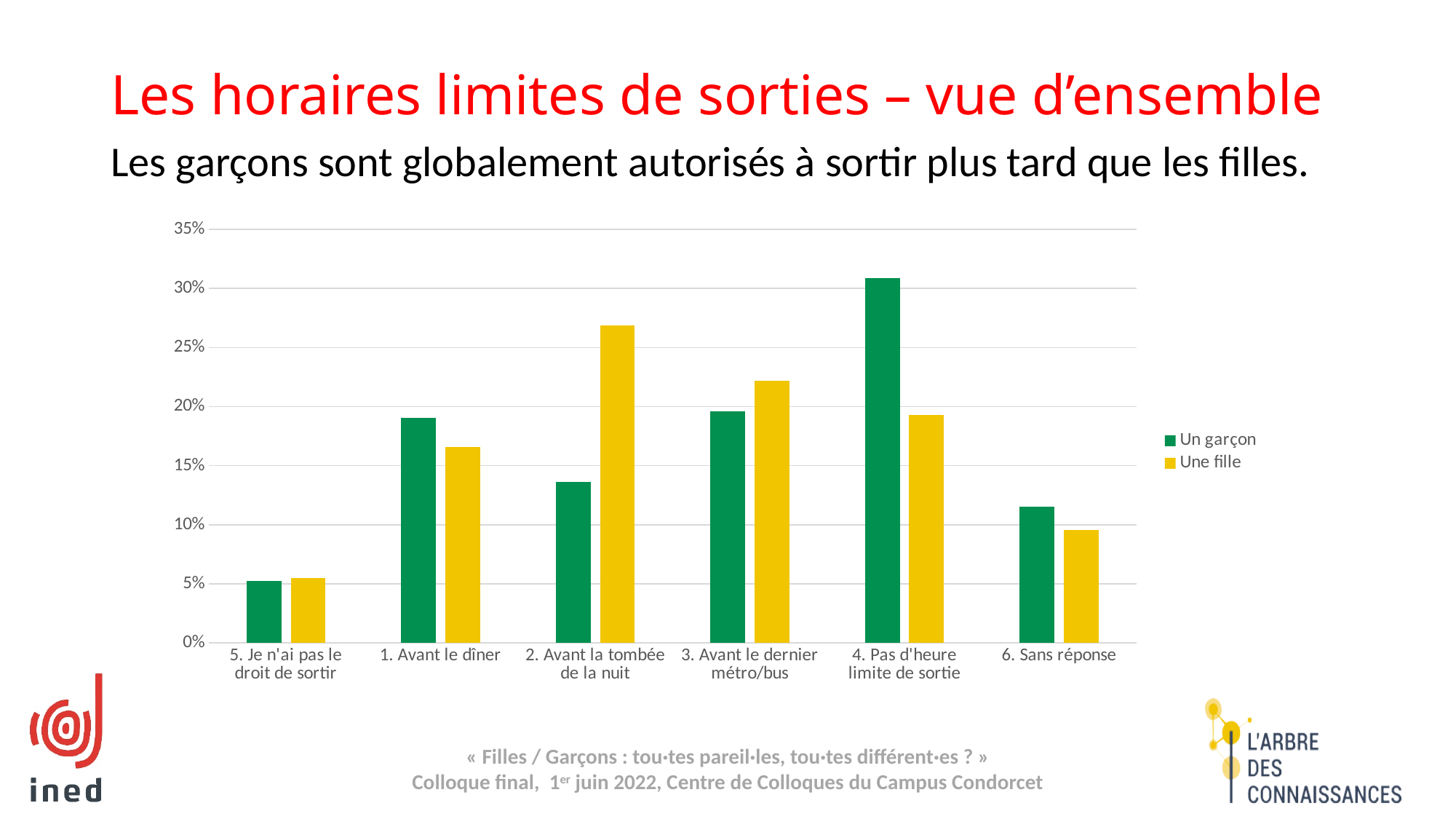
What kind of chart is shown on the slide? Bar chart For which category is the value for 'Un garçon' the highest? 4. Pas d'heure limite de sortie Is the value for 'Une fille' in '1. Avant le dîner' greater or less than 20%? less Is the value for 'Un garçon' in '4. Pas d'heure limite de sortie' greater or less than 25%? greater For which category is the value for 'Une fille' the highest? 2. Avant la tombée de la nuit How many series does the legend list? 2 Which colour represents the series 'Une fille' in the legend? Yellow Is the value for 'Un garçon' in '2. Avant la tombée de la nuit' greater or less than 15%? less For which category is the value for 'Une fille' the lowest? 5. Je n'ai pas le droit de sortir In '4. Pas d'heure limite de sortie', which series has the larger value, 'Un garçon' or 'Une fille'? Un garçon How many categories are shown on the x axis? 6 In '2. Avant la tombée de la nuit', which series has the larger value, 'Un garçon' or 'Une fille'? Une fille